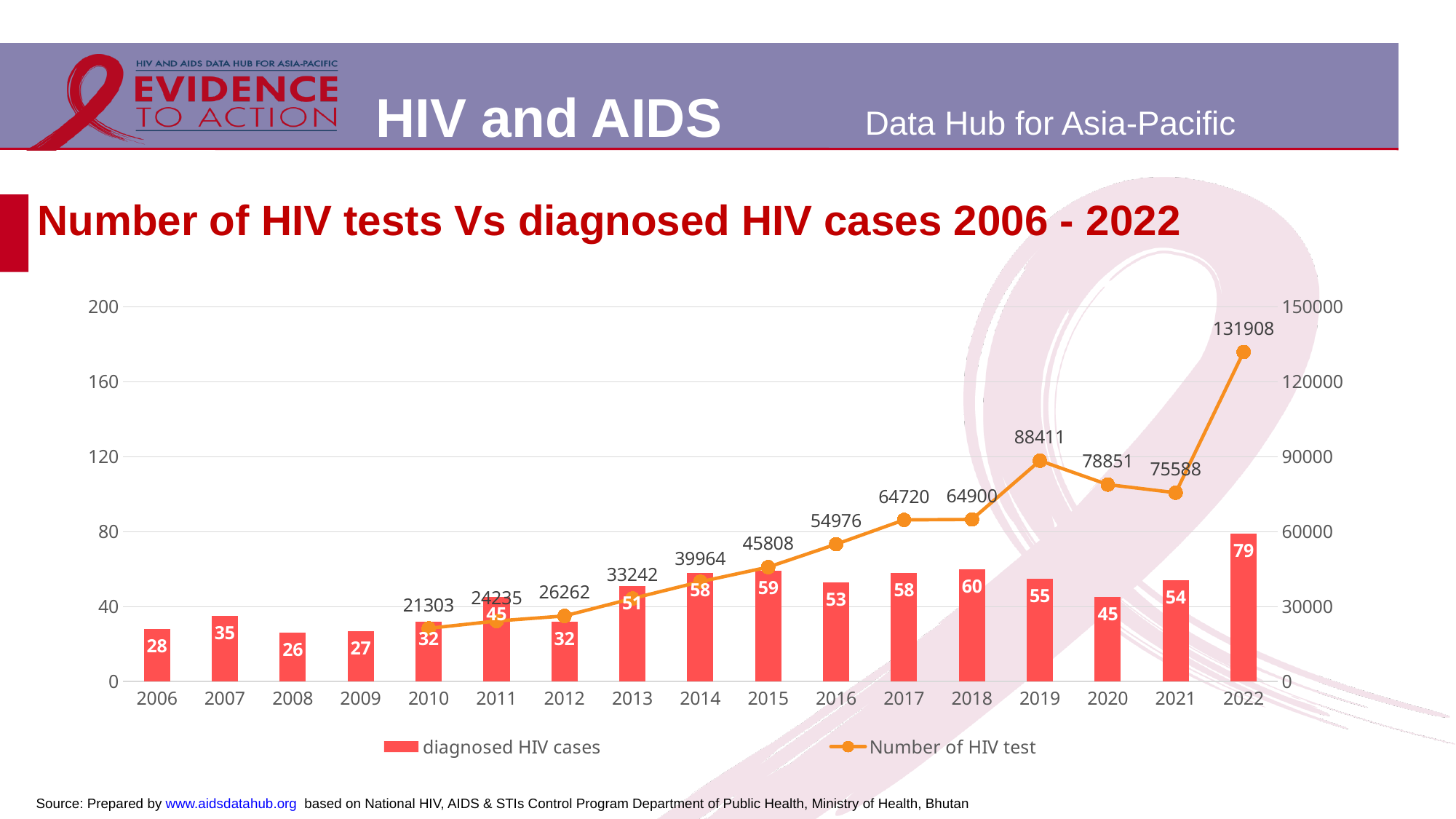
What is the difference in the number of HIV tests between 2022 and 2021? 56320 What kind of chart is used to show the number of HIV tests? Line chart Which year had more HIV tests, 2020 or 2021? 2020 How many series does the legend list? 2 Which year had more diagnosed HIV cases, 2011 or 2013? 2013 What is the difference in diagnosed HIV cases between 2018 and 2020? 15 How many diagnosed HIV cases are shown for 2022? 79 What is the number of HIV tests shown for 2010? 21303 Which year has the highest number of diagnosed HIV cases? 2022 Which year has the lowest number of diagnosed HIV cases? 2008 What is the number of HIV tests shown for 2019? 88411 How many years are shown on the x axis? 17